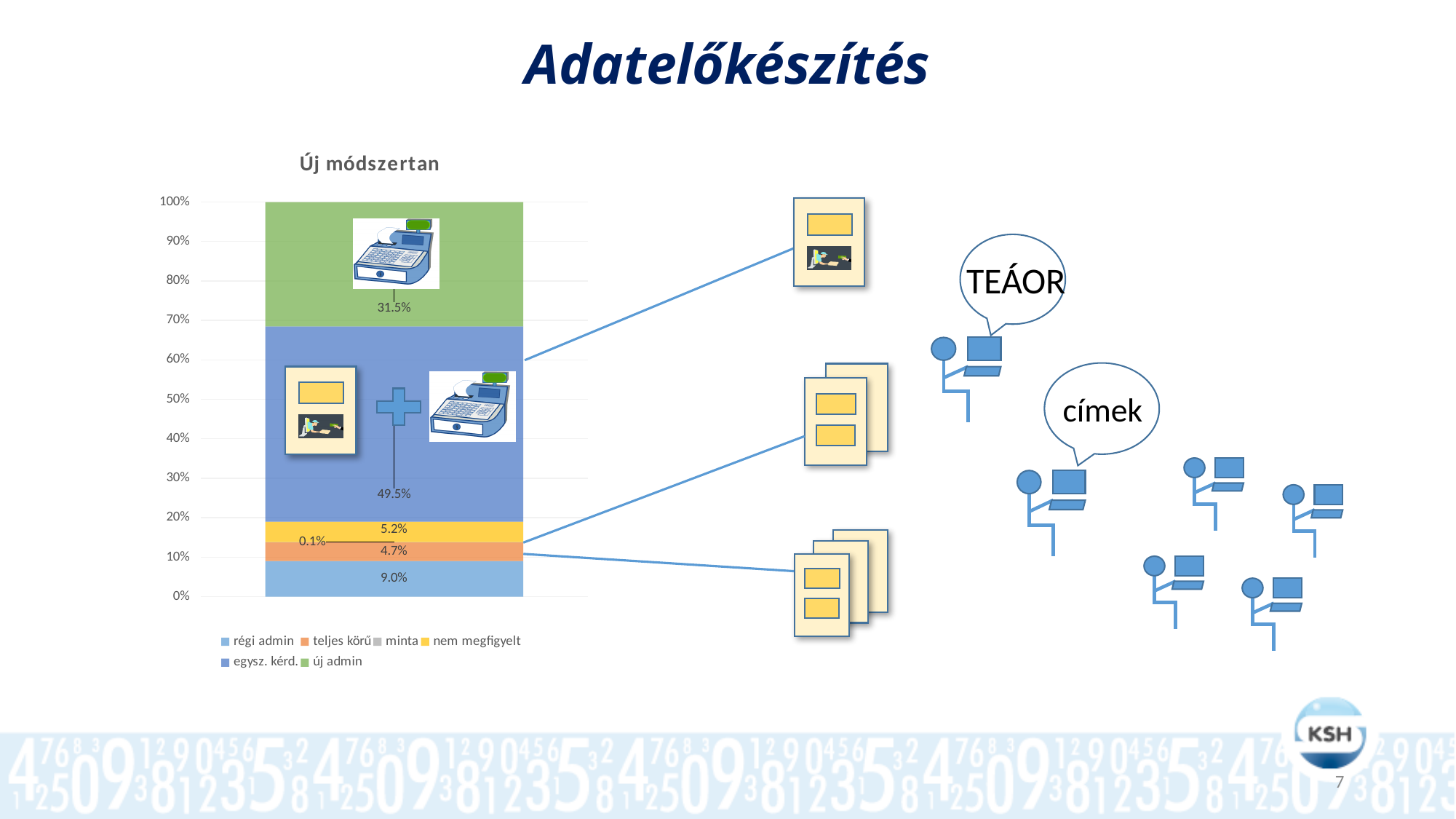
What is the value of the 'egysz. kérd.' segment? 49.5% What is the value of the 'nem megfigyelt' segment? 5.2% Which segment has the smallest share of the bar? minta What kind of chart is shown on the slide? stacked bar chart What is the difference between the 'egysz. kérd.' and 'új admin' segments? 18.0% What is the value of the 'régi admin' segment? 9.0% How many series does the chart legend list? 6 What is the value of the 'minta' segment? 0.1% Which segment has the largest share of the bar? egysz. kérd. What is the value of the 'új admin' segment? 31.5% What is the title of the chart? Új módszertan Which is larger, the 'teljes körű' segment or the 'nem megfigyelt' segment? nem megfigyelt